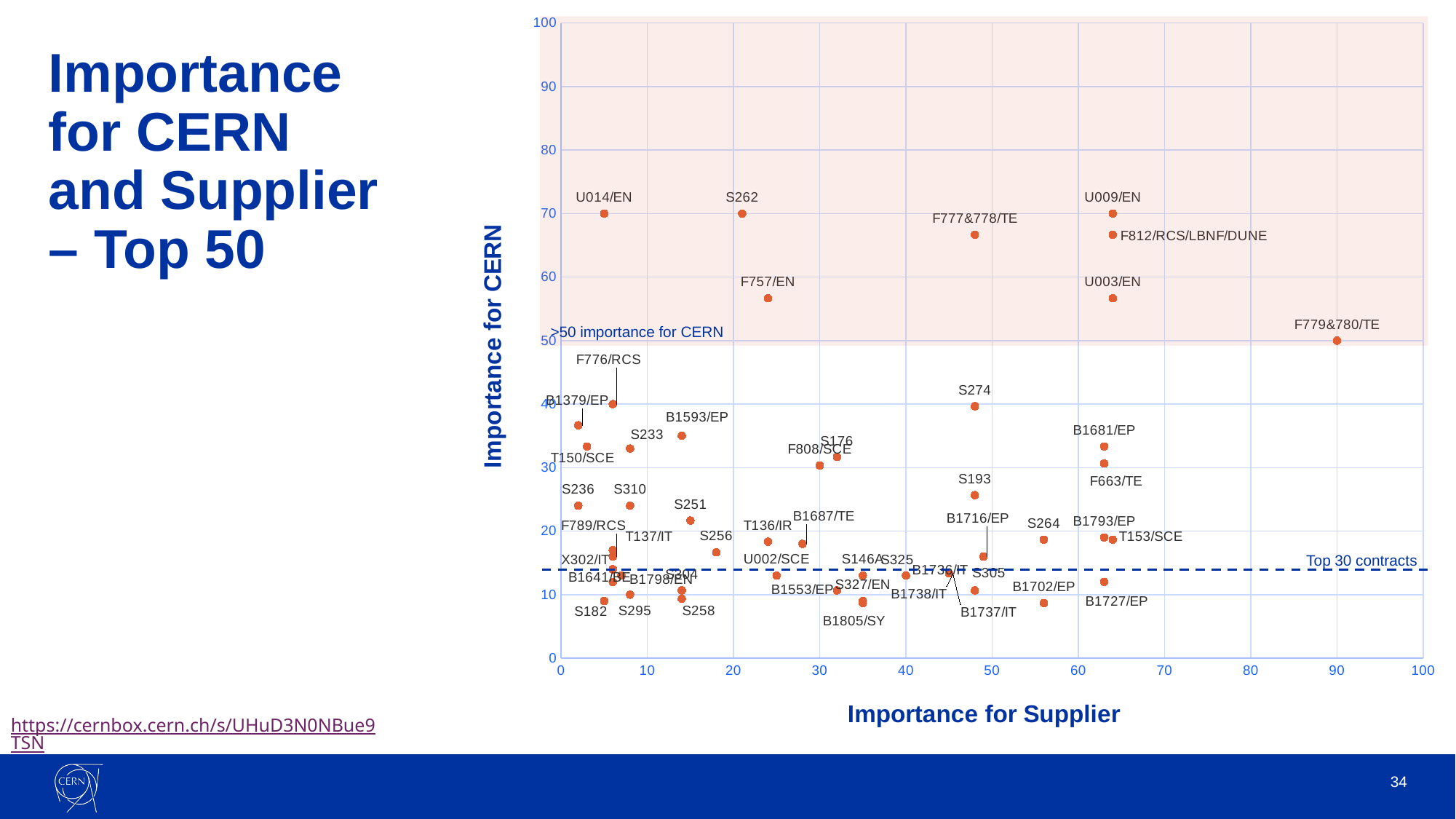
What is the importance for supplier value of F779&780/TE? 90 What is the title of the x axis? Importance for Supplier Is the importance for CERN value of F757/EN greater or less than 50? greater Is the importance for supplier value of F779&780/TE greater or less than 80? greater Which point has the highest importance for supplier? F779&780/TE Which has the higher importance for CERN, S262 or S274? S262 Which has the higher importance for supplier, U014/EN or U009/EN? U009/EN What is the importance for CERN value of U014/EN? 70 Is the importance for CERN value of F777&778/TE greater or less than 60? greater What is the title of the y axis? Importance for CERN What kind of chart is shown on the slide? scatter chart